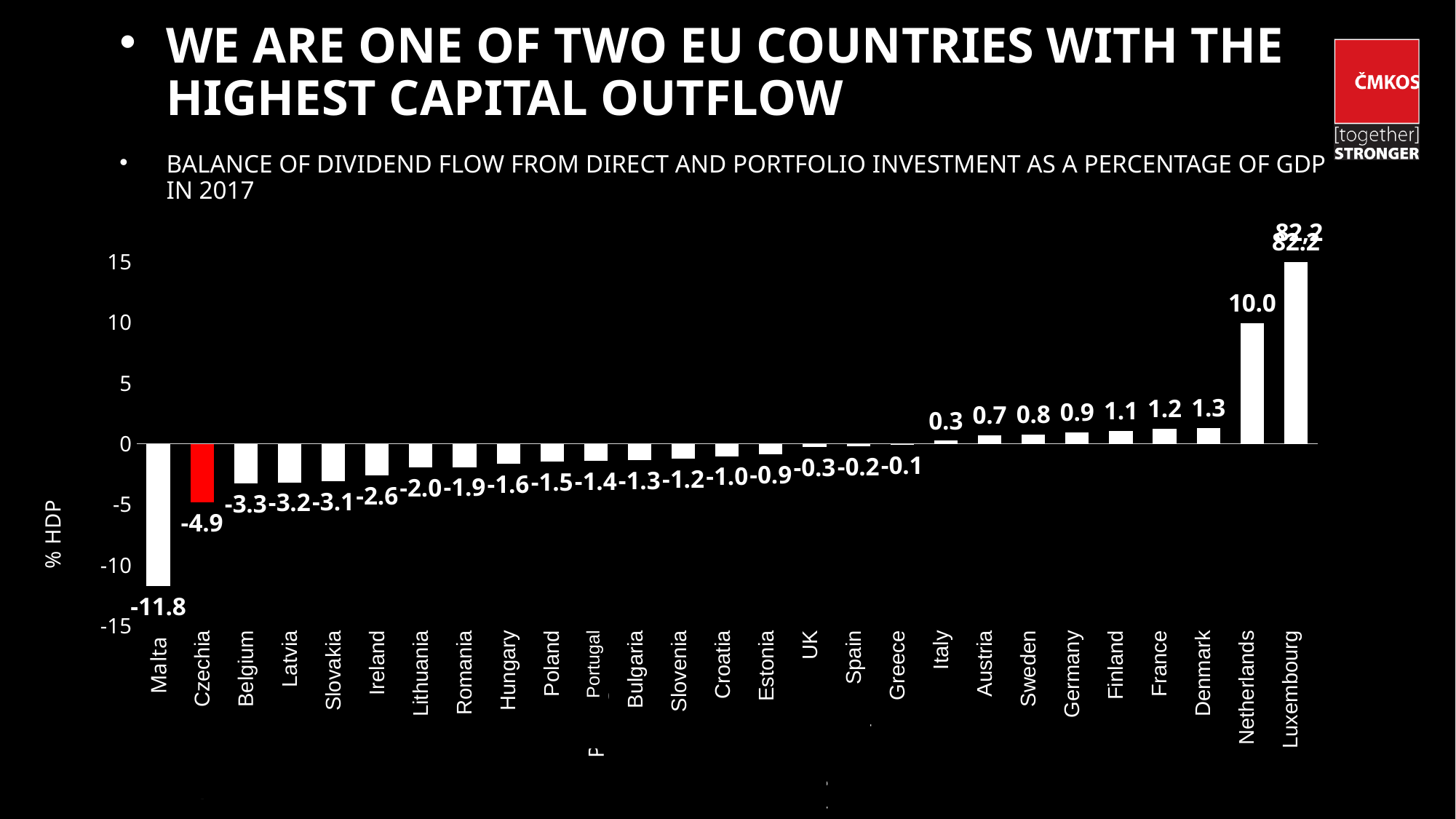
Which country has the lowest value? Malta What is the value for Czechia? -4.9 Which country's bar is highlighted in red? Czechia How many countries are shown in the chart? 27 Which country has the highest value? Luxembourg What kind of chart is shown on the slide? Bar chart Which has a larger value, Ireland or Slovakia? Ireland What is the value for Denmark? 1.3 What is the value for Netherlands? 10.0 What is the difference between the values for Netherlands and Denmark? 8.7 What is the value for Malta? -11.8 What is the value for Luxembourg? 82.2